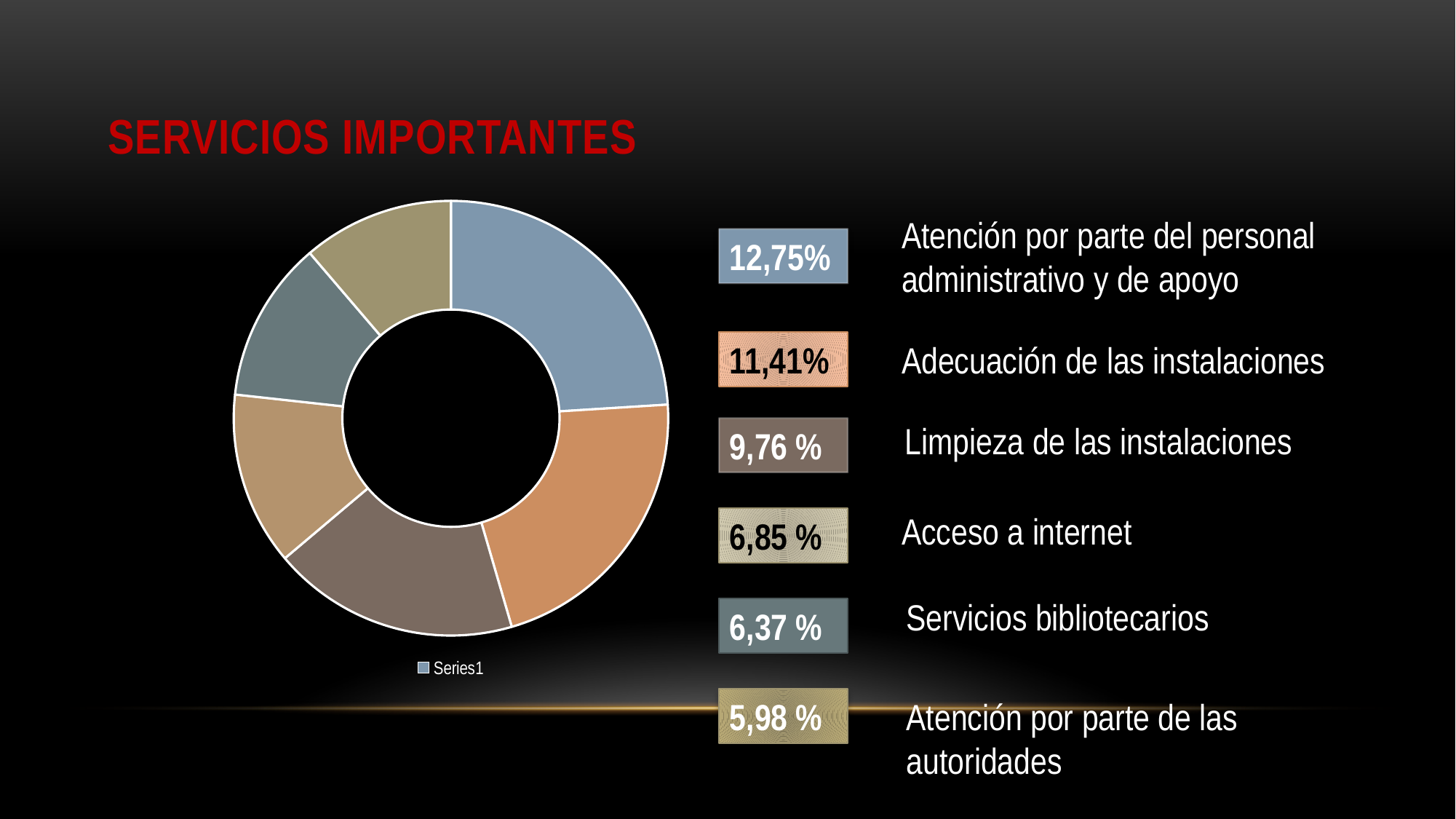
How many slices does the doughnut chart have? 6 What kind of chart is shown on the slide? Doughnut chart What value is shown for Acceso a internet? 6,85 % Which is larger, the value for Limpieza de las instalaciones or the value for Acceso a internet? Limpieza de las instalaciones How many series does the chart legend list? 1 What is the name of the series shown in the chart legend? Series1 What is the difference between the values for Atención por parte del personal administrativo y de apoyo and Adecuación de las instalaciones? 1,34% What value is shown for Limpieza de las instalaciones? 9,76 % What is the chart's title? SERVICIOS IMPORTANTES Which category has the highest value? Atención por parte del personal administrativo y de apoyo What value is shown for Servicios bibliotecarios? 6,37 % Which category has the lowest value? Atención por parte de las autoridades